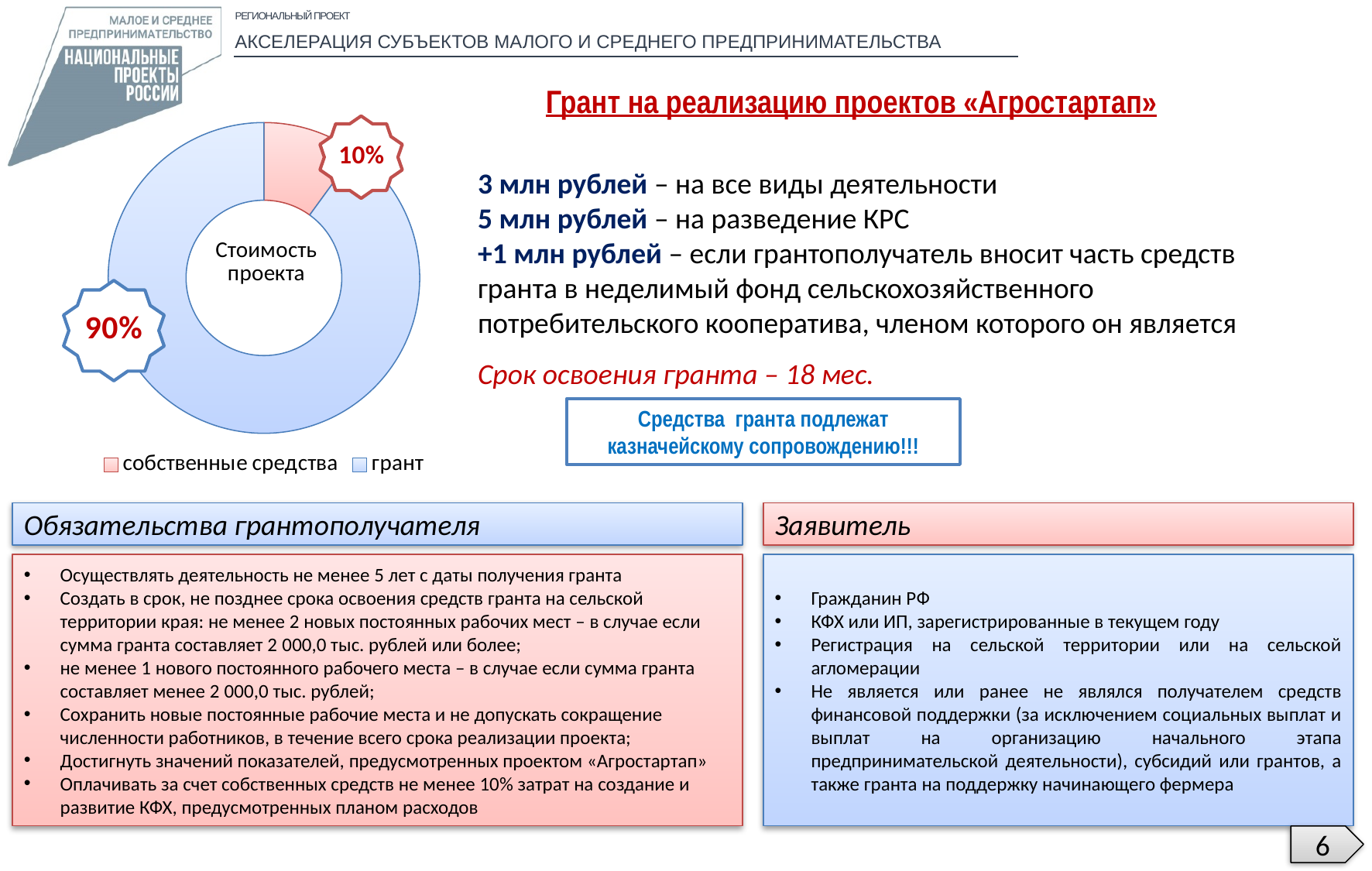
What share of the project cost does the "грант" slice represent? 90% What is the total of the two slices shown in the chart? 100% Which slice of the chart is the largest? грант Which slice of the chart is the smallest? собственные средства What kind of chart is shown on the slide? doughnut chart Which is larger: the "грант" slice or the "собственные средства" slice? грант What share of the project cost does the "собственные средства" slice represent? 10% How many entries does the chart legend list? 2 What text is written in the centre of the doughnut chart? Стоимость проекта How many slices does the chart have? 2 What is the difference in percentage points between the "грант" slice and the "собственные средства" slice? 80 Which colour represents "собственные средства" in the chart? pink (red)